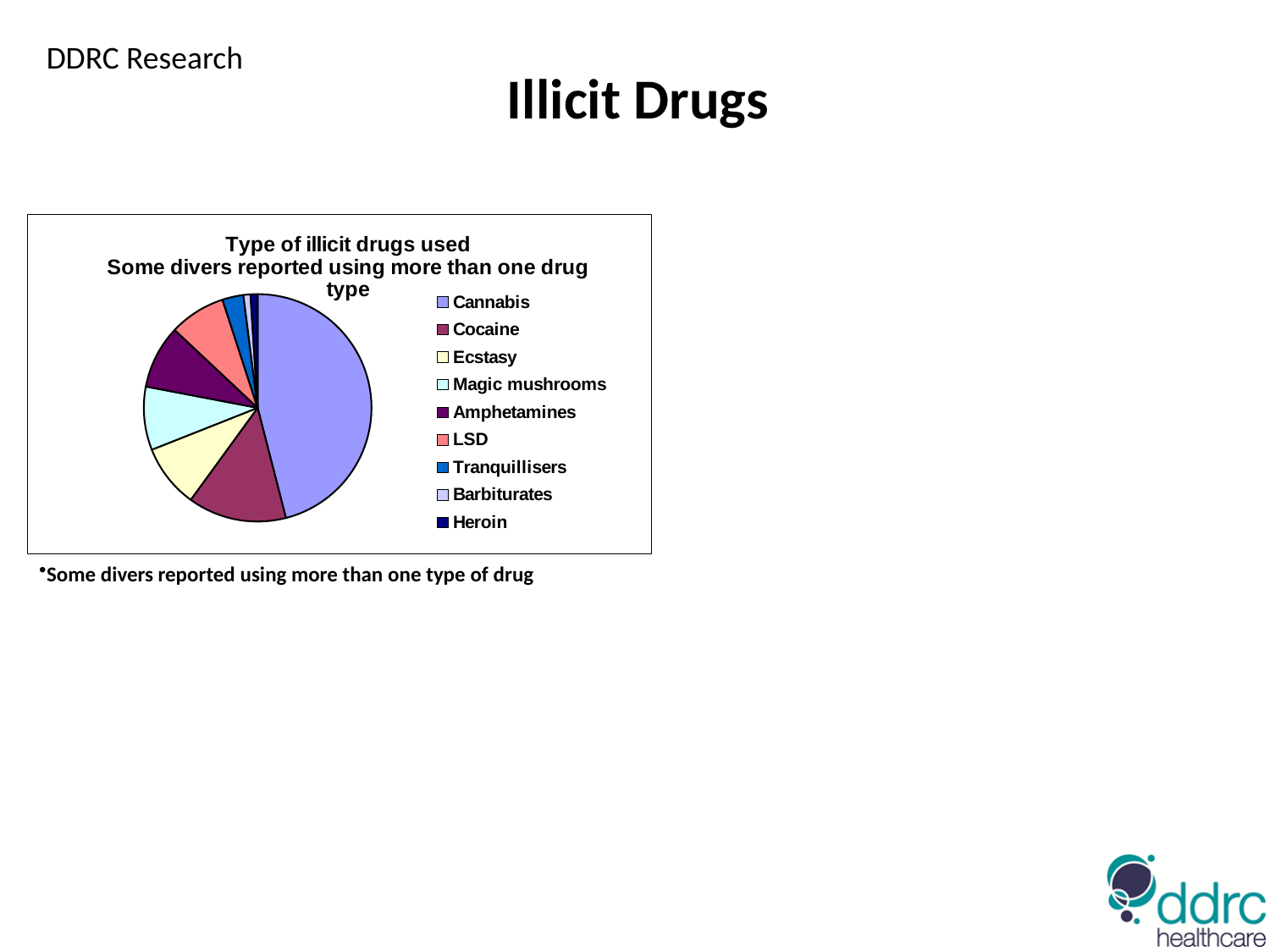
Which slice is larger, Amphetamines or Heroin? Amphetamines How many drug types does the pie chart's legend list? 9 Which slice is larger, Cocaine or Ecstasy? Cocaine Which drug type has the largest slice of the pie chart? Cannabis What kind of chart is shown on the slide? Pie chart Which slice is larger, LSD or Tranquillisers? LSD What is the first line of the chart's title? Type of illicit drugs used Which drug type is listed last in the chart's legend? Heroin